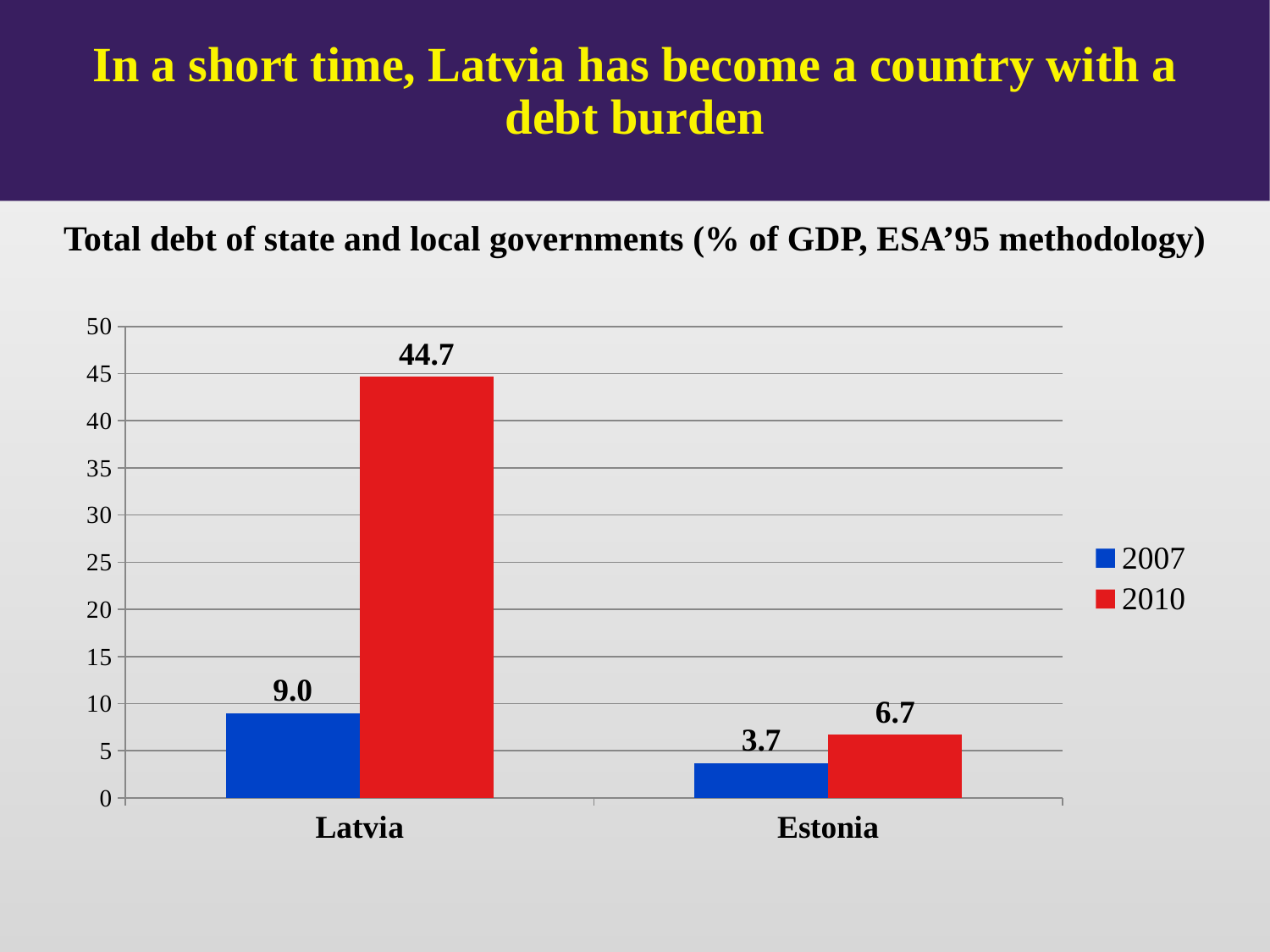
What is the value for Latvia in 2007? 9.0 Which country has the lowest value in 2007? Estonia What is the value for Estonia in 2010? 6.7 Which is larger: Latvia's 2007 value or Estonia's 2010 value? Latvia's 2007 value What is the value for Latvia in 2010? 44.7 What is the difference between Estonia's 2010 and 2007 values? 3.0 Which country has the highest value in 2010? Latvia What is the value for Estonia in 2007? 3.7 How many countries are shown on the x axis? 2 What kind of chart is shown on the slide? Bar chart How many series does the legend list? 2 What is the difference between Latvia's 2010 and 2007 values? 35.7